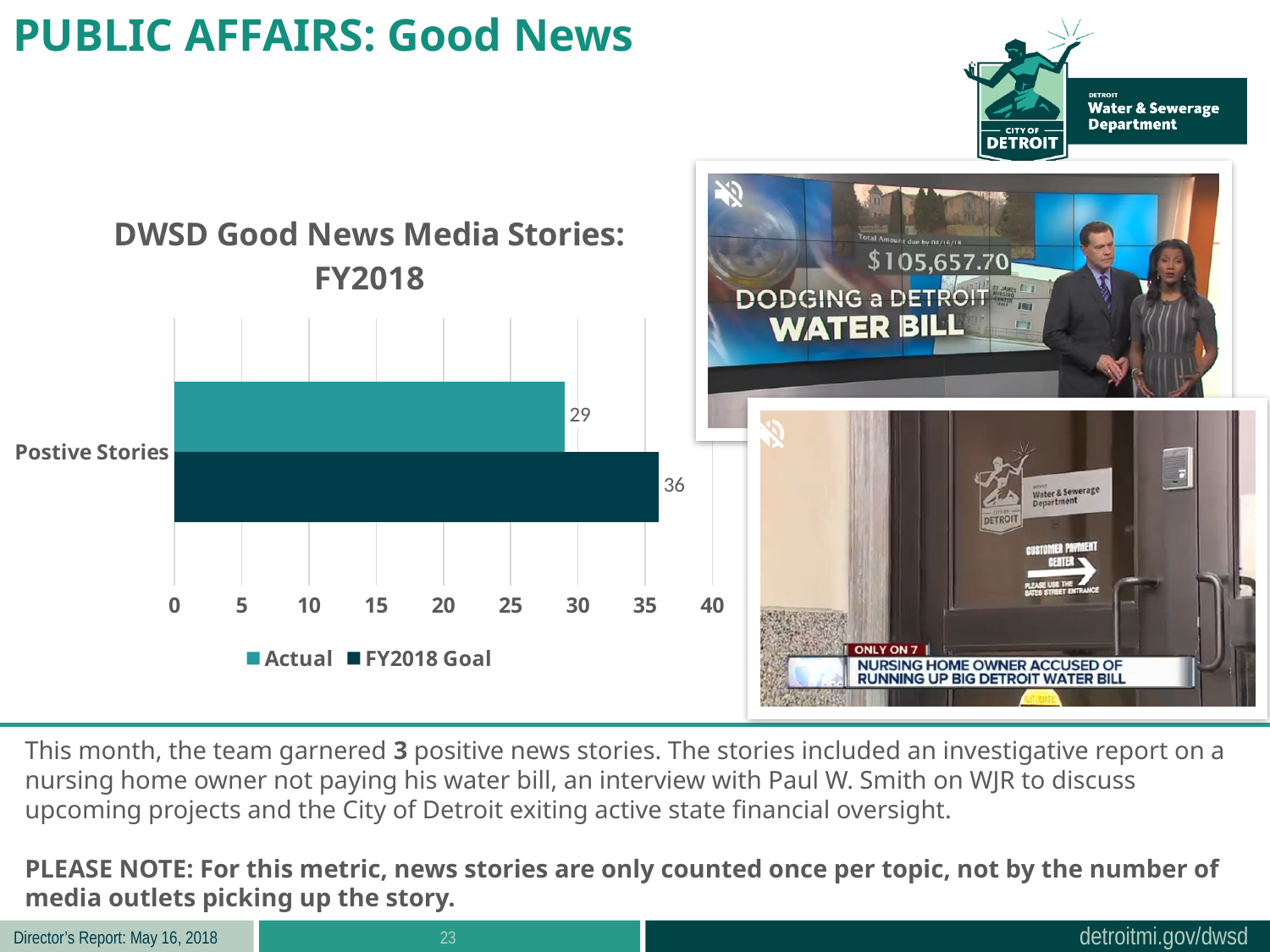
What is the maximum value shown on the chart's x axis? 40 What is the title of the chart? DWSD Good News Media Stories: FY2018 Which is larger for Postive Stories, the Actual value or the FY2018 Goal? FY2018 Goal Is the Actual value for Postive Stories greater or less than 30? less How many categories are shown on the chart? 1 What is the difference between the FY2018 Goal and the Actual value for Postive Stories? 7 Is the FY2018 Goal value for Postive Stories greater or less than 35? greater What kind of chart is shown on the slide? Bar chart What is the FY2018 Goal value for Postive Stories? 36 How many series does the legend list? 2 What is the Actual value for Postive Stories? 29 What are the two series listed in the chart legend? Actual and FY2018 Goal